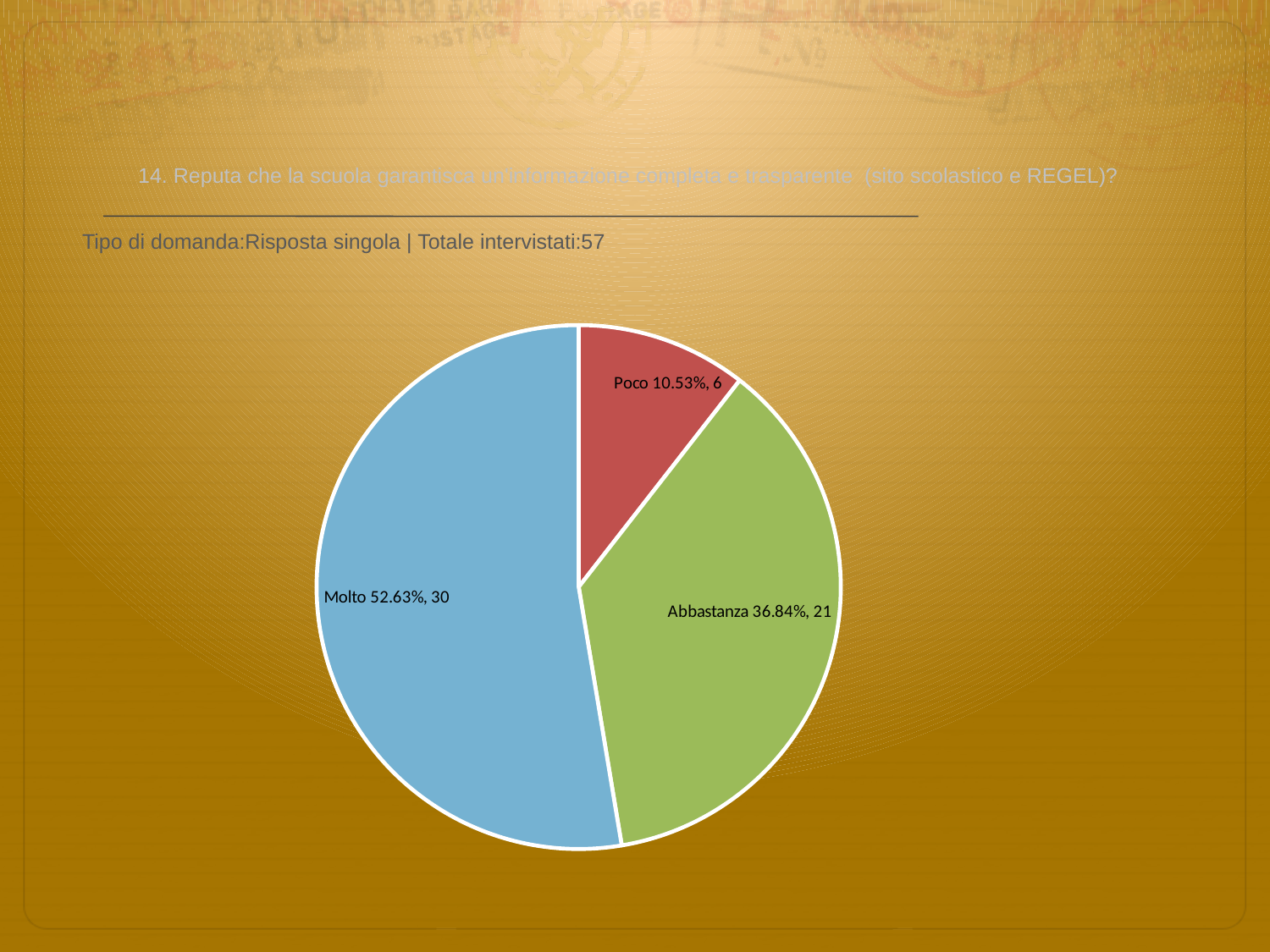
What kind of chart is shown on the slide? pie chart Which has more respondents, "Abbastanza" or "Poco"? Abbastanza How many slices does the pie chart have? 3 How many respondents answered "Poco"? 6 What is the total number of respondents across all three slices? 57 Which response has the largest share of the pie? Molto What percentage of respondents answered "Poco"? 10.53% Which response has the smallest share of the pie? Poco What is the difference in the number of respondents between "Molto" and "Abbastanza"? 9 How many respondents answered "Abbastanza"? 21 What percentage of respondents answered "Molto"? 52.63% What colour is the "Molto" slice? blue